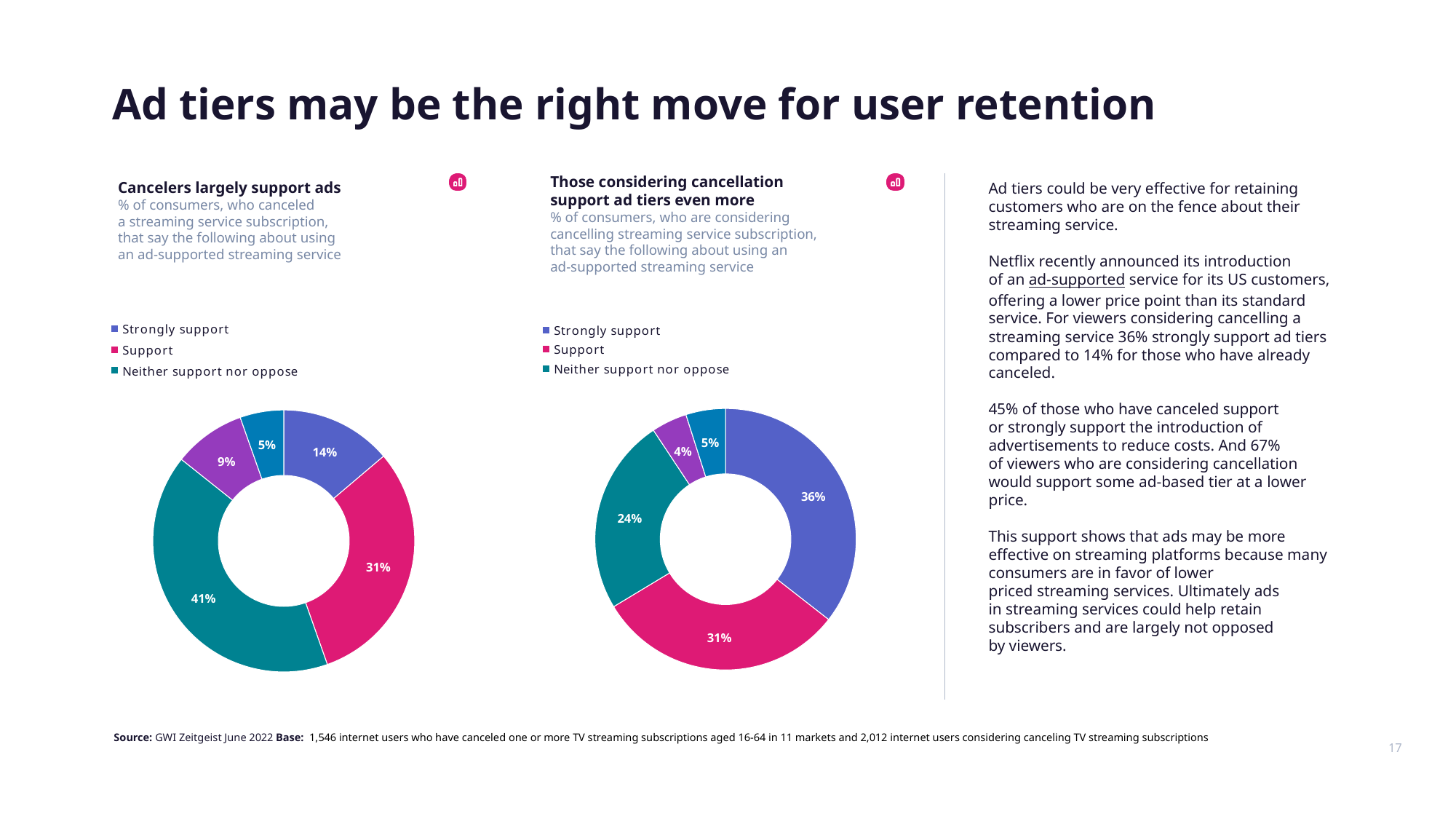
In the 'Those considering cancellation support ad tiers even more' chart, what percentage neither support nor oppose? 24% In the 'Those considering cancellation support ad tiers even more' chart, what is the combined share of 'Strongly support' and 'Support'? 67% In the 'Cancelers largely support ads' chart, what is the combined share of 'Strongly support' and 'Support'? 45% How many slices does the 'Cancelers largely support ads' chart have? 5 In the 'Cancelers largely support ads' chart, what percentage neither support nor oppose? 41% In the 'Cancelers largely support ads' chart, what percentage of consumers strongly support using an ad-supported streaming service? 14% What is the difference in the 'Strongly support' percentage between the 'Those considering cancellation' chart and the 'Cancelers largely support ads' chart? 22 percentage points In the 'Cancelers largely support ads' chart, which category has the largest share? Neither support nor oppose What type of chart is used on this slide? Donut (pie) chart Which chart shows a larger 'Neither support nor oppose' share, the 'Cancelers largely support ads' chart or the 'Those considering cancellation' chart? Cancelers largely support ads In the 'Those considering cancellation support ad tiers even more' chart, what percentage strongly support? 36% In the 'Those considering cancellation support ad tiers even more' chart, which category has the largest share? Strongly support